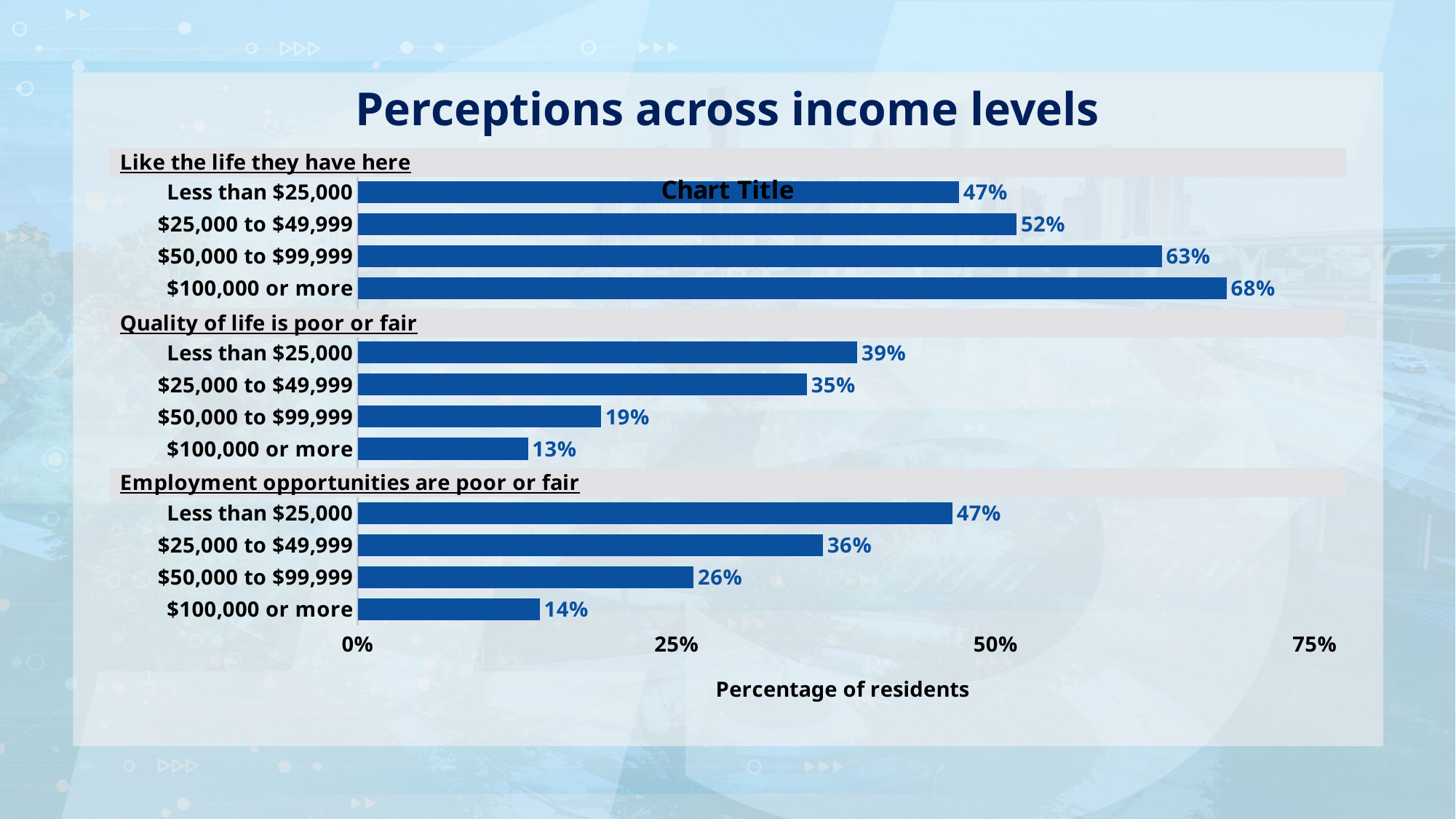
Under 'Like the life they have here', do the values rise or fall as income increases from less than $25,000 to $100,000 or more? Rise What percentage of residents earning $50,000 to $99,999 say employment opportunities are poor or fair? 26% What is the difference between the percentage of residents earning less than $25,000 and those earning $100,000 or more who say employment opportunities are poor or fair? 33% What percentage of residents earning less than $25,000 say quality of life is poor or fair? 39% Which income group has the lowest percentage saying quality of life is poor or fair? $100,000 or more How many bars are plotted on the chart in total? 12 What kind of chart is shown on the slide? Bar chart Is the value for $50,000 to $99,999 under 'Like the life they have here' greater or less than 50%? greater Which income group has the highest percentage saying they like the life they have here? $100,000 or more What percentage of residents earning $100,000 or more like the life they have here? 68% Under 'Quality of life is poor or fair', which is larger: the value for $25,000 to $49,999 or the value for $50,000 to $99,999? $25,000 to $49,999 What is the label on the horizontal axis of the chart? Percentage of residents